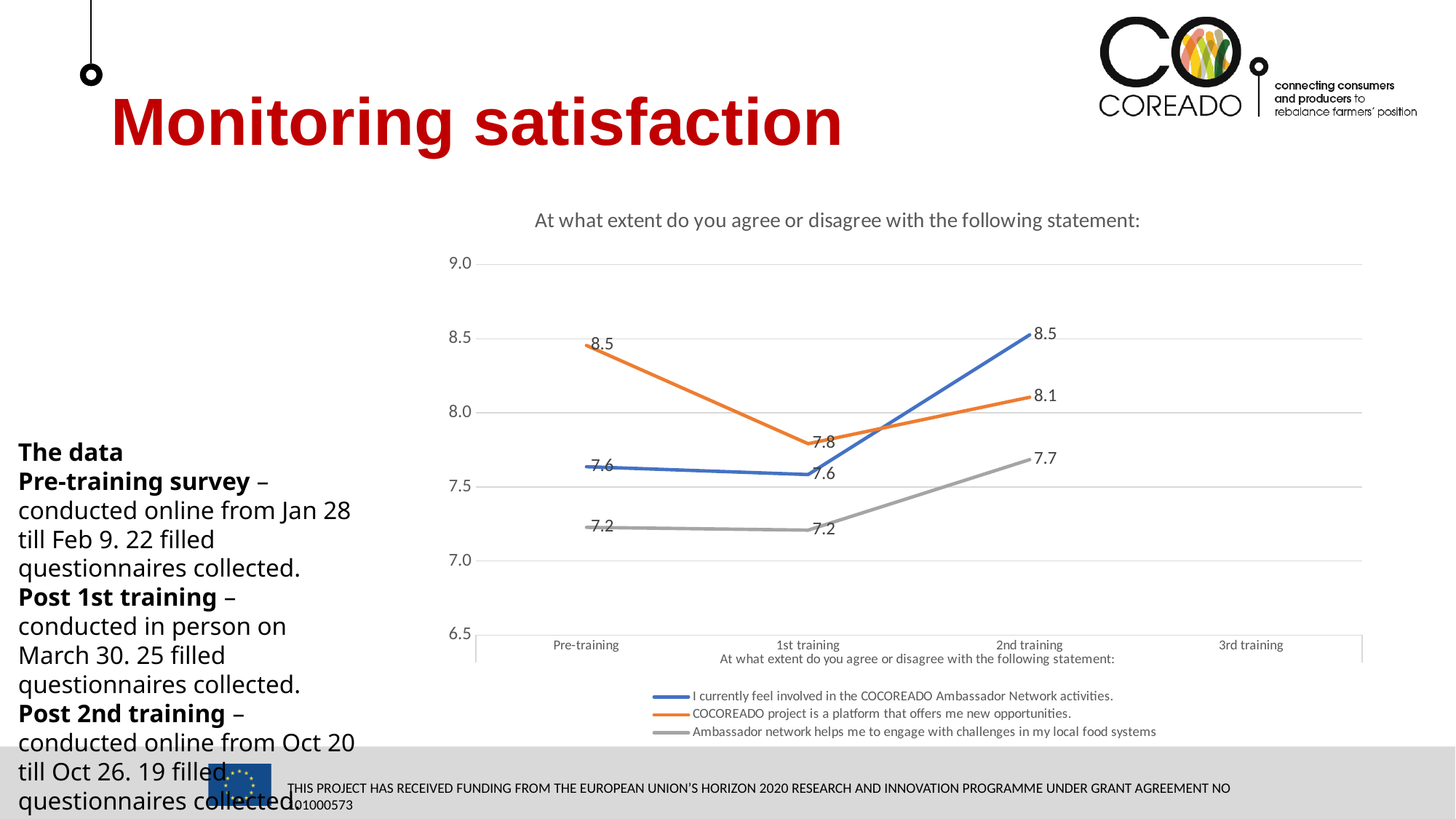
What is the title of the chart? At what extent do you agree or disagree with the following statement: What is the value for 'Ambassador network helps me to engage with challenges in my local food systems' at 1st training? 7.2 How many series does the legend list? 3 Which series has the highest value at Pre-training? COCOREADO project is a platform that offers me new opportunities. At which survey point is the value for 'COCOREADO project is a platform that offers me new opportunities.' lowest? 1st training What is the difference between the 2nd training and 1st training values for 'I currently feel involved in the COCOREADO Ambassador Network activities.'? 0.9 How many categories are labelled on the x axis? 4 At 2nd training, which is larger: the value for 'I currently feel involved in the COCOREADO Ambassador Network activities.' or the value for 'COCOREADO project is a platform that offers me new opportunities.'? I currently feel involved in the COCOREADO Ambassador Network activities. Does the value for 'Ambassador network helps me to engage with challenges in my local food systems' rise or fall from 1st training to 2nd training? rise What is the value for 'COCOREADO project is a platform that offers me new opportunities.' at Pre-training? 8.5 What is the value for 'I currently feel involved in the COCOREADO Ambassador Network activities.' at 2nd training? 8.5 What type of chart is shown on the slide? line chart